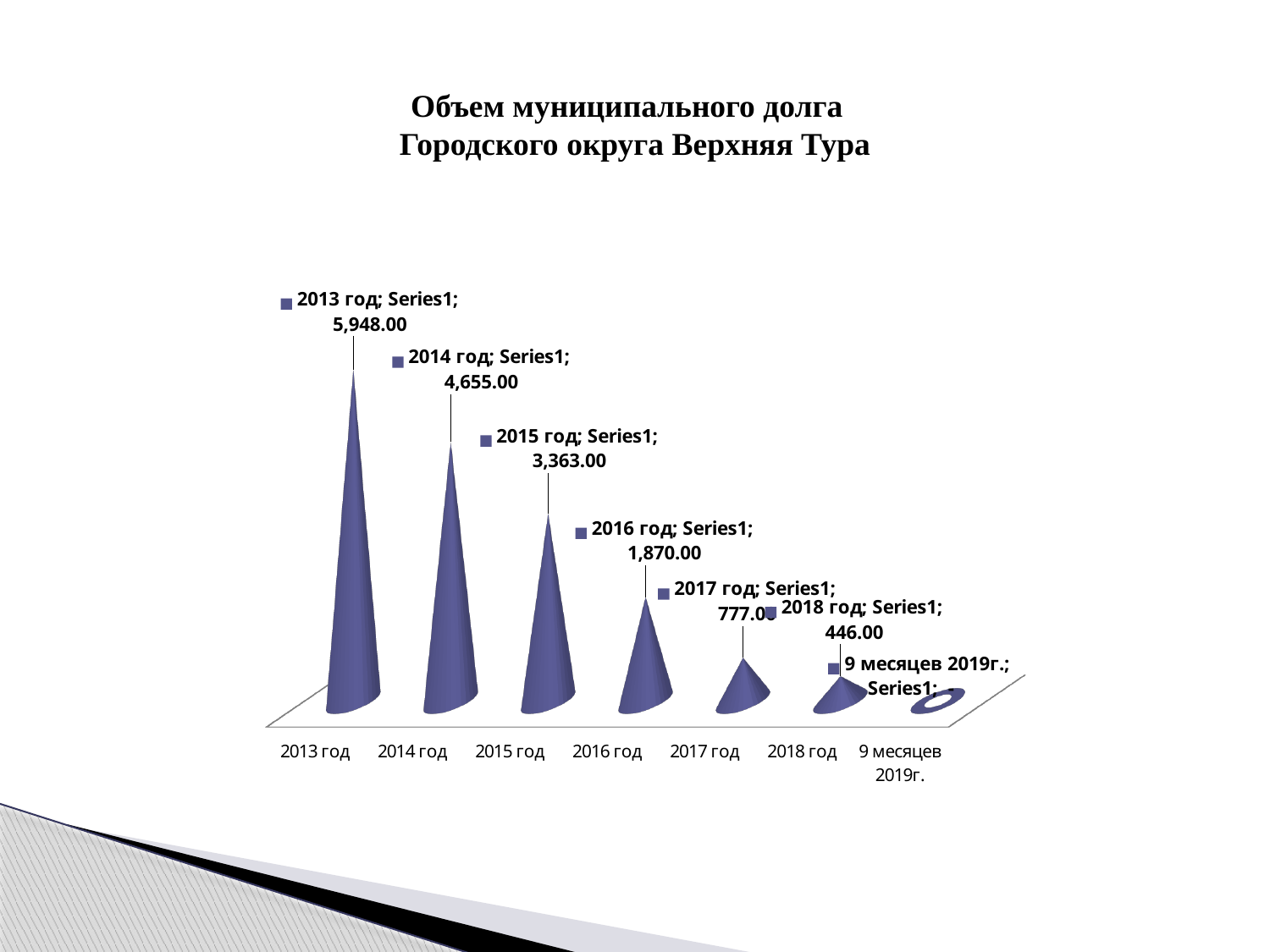
What is the value for 2018 год? 446.00 What is the value for 2016 год? 1,870.00 What is the title of the chart? Объем муниципального долга Городского округа Верхняя Тура Do the values rise or fall from 2013 год to 9 месяцев 2019г.? fall How many categories are shown on the x axis? 7 What is the value for 2013 год? 5,948.00 What is the value for 2014 год? 4,655.00 What is the value for 2015 год? 3,363.00 Which is larger, the value for 2017 год or the value for 2018 год? 2017 год Which category has the highest value? 2013 год Which category has the lowest value? 9 месяцев 2019г. What is the difference between the values for 2013 год and 2014 год? 1,293.00